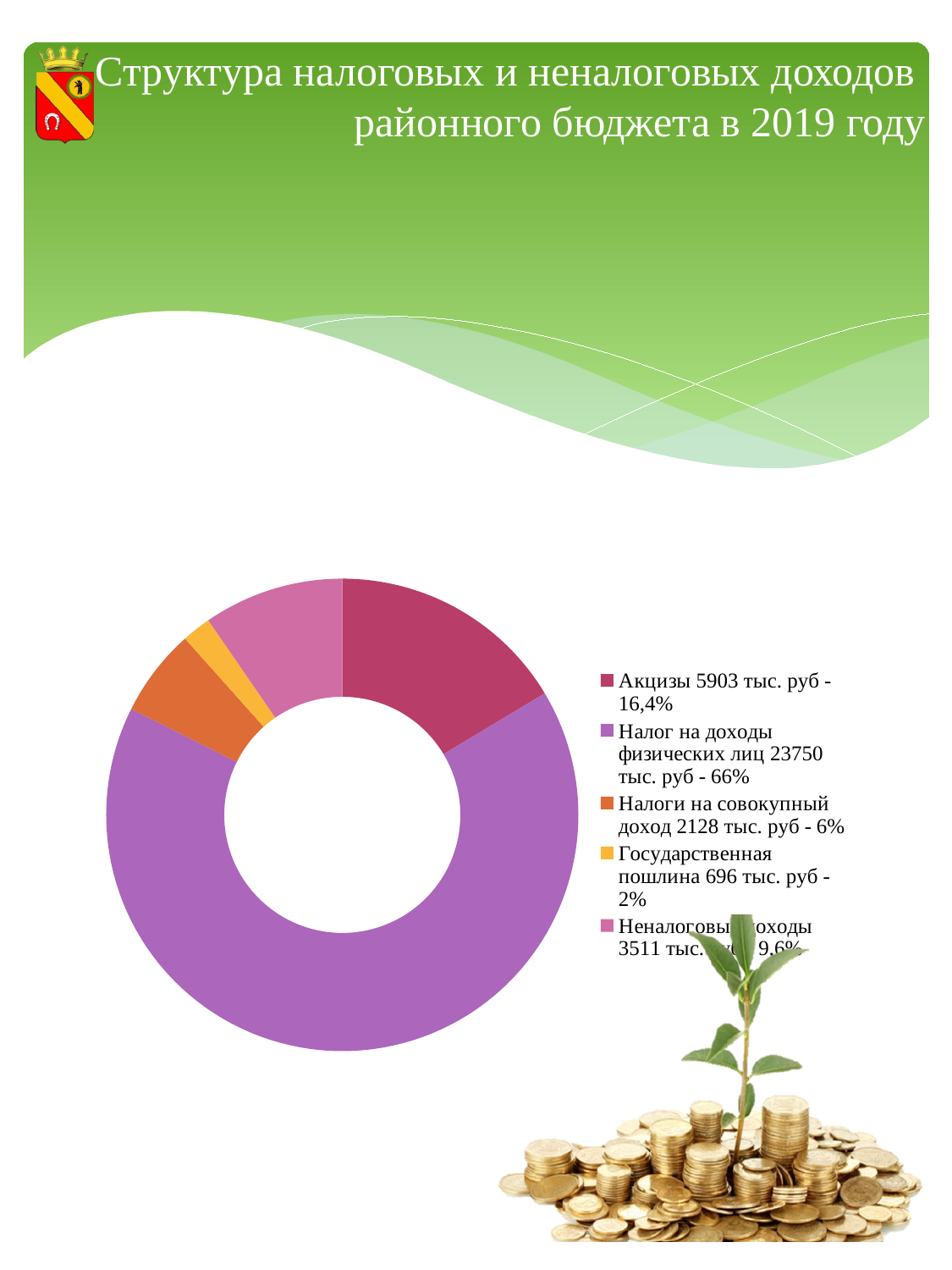
What share of the chart does Государственная пошлина represent? 2% Which category has the smallest share of the chart? Государственная пошлина What is the difference in thousand rubles between Акцизы and Налоги на совокупный доход? 3775 тыс. руб What kind of chart is shown on the slide? doughnut chart What is the title of the slide containing the chart? Структура налоговых и неналоговых доходов районного бюджета в 2019 году What is the value for Акцизы in thousand rubles? 5903 тыс. руб What is the value for Налоги на совокупный доход in thousand rubles? 2128 тыс. руб What share of the chart does Налог на доходы физических лиц represent? 66% How many categories does the legend of the chart list? 5 What is the value for Налог на доходы физических лиц in thousand rubles? 23750 тыс. руб Which is larger, the value for Акцизы or the value for Налоги на совокупный доход? Акцизы Which category has the largest share of the chart? Налог на доходы физических лиц